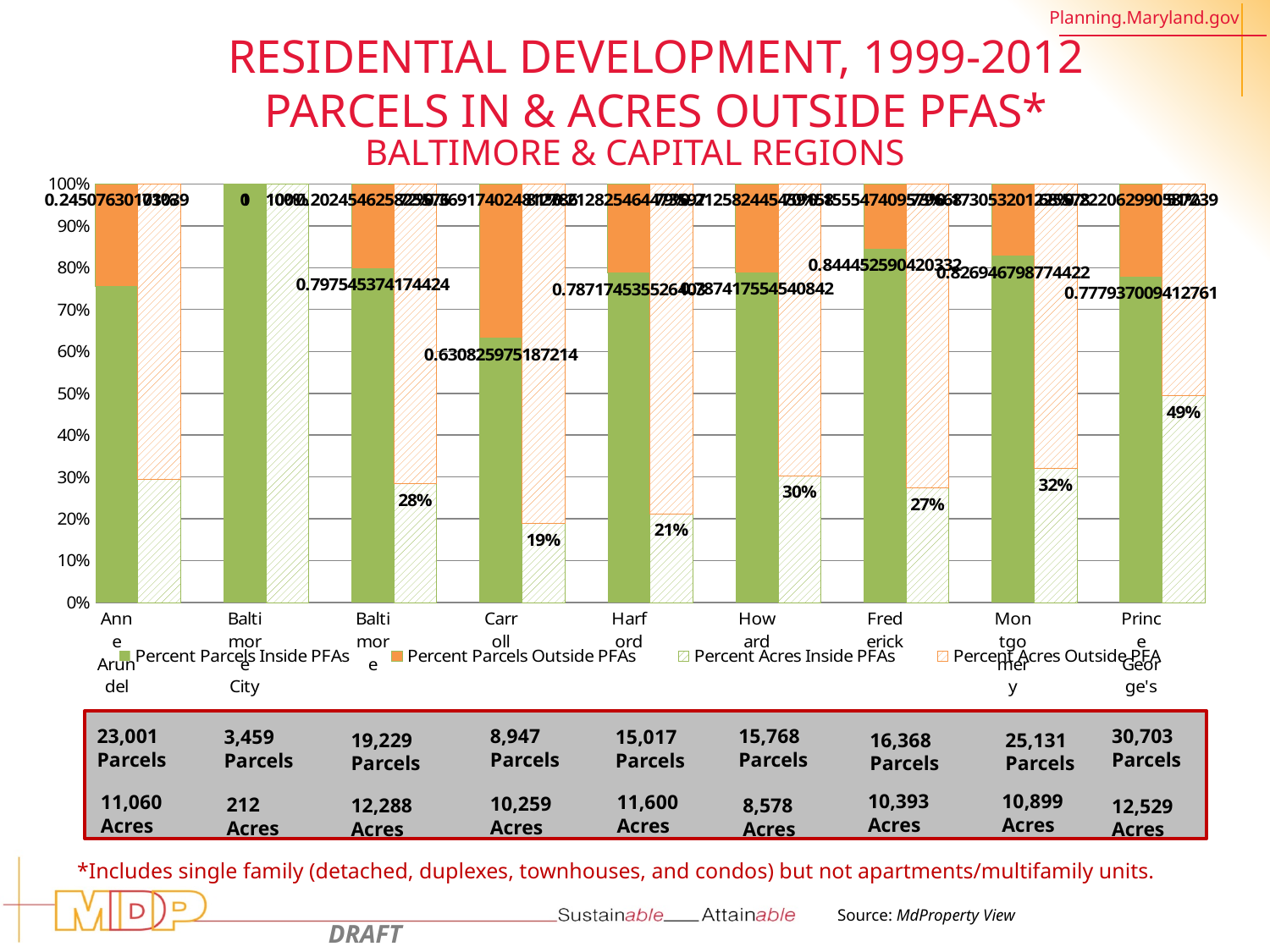
How many series does the chart legend list? 4 What is the Percent Acres Inside PFAs value labeled for Carroll? 19% Which legend series is shown in solid green? Percent Parcels Inside PFAs What is the Percent Acres Inside PFAs value labeled for Montgomery? 32% What is the difference between the Percent Acres Inside PFAs for Prince George's and for Montgomery? 17% Which is larger, the Percent Acres Inside PFAs for Howard or for Frederick? Howard Which county has the lowest labeled Percent Acres Inside PFAs value? Carroll What is the Percent Acres Inside PFAs value labeled for Prince George's? 49% Is the Percent Parcels Inside PFAs value for Howard greater or less than 70%? greater What kind of chart is shown on the slide? bar chart Is the Percent Parcels Inside PFAs value for Carroll greater or less than 70%? less How many counties/jurisdictions are shown along the x axis of the chart? 9